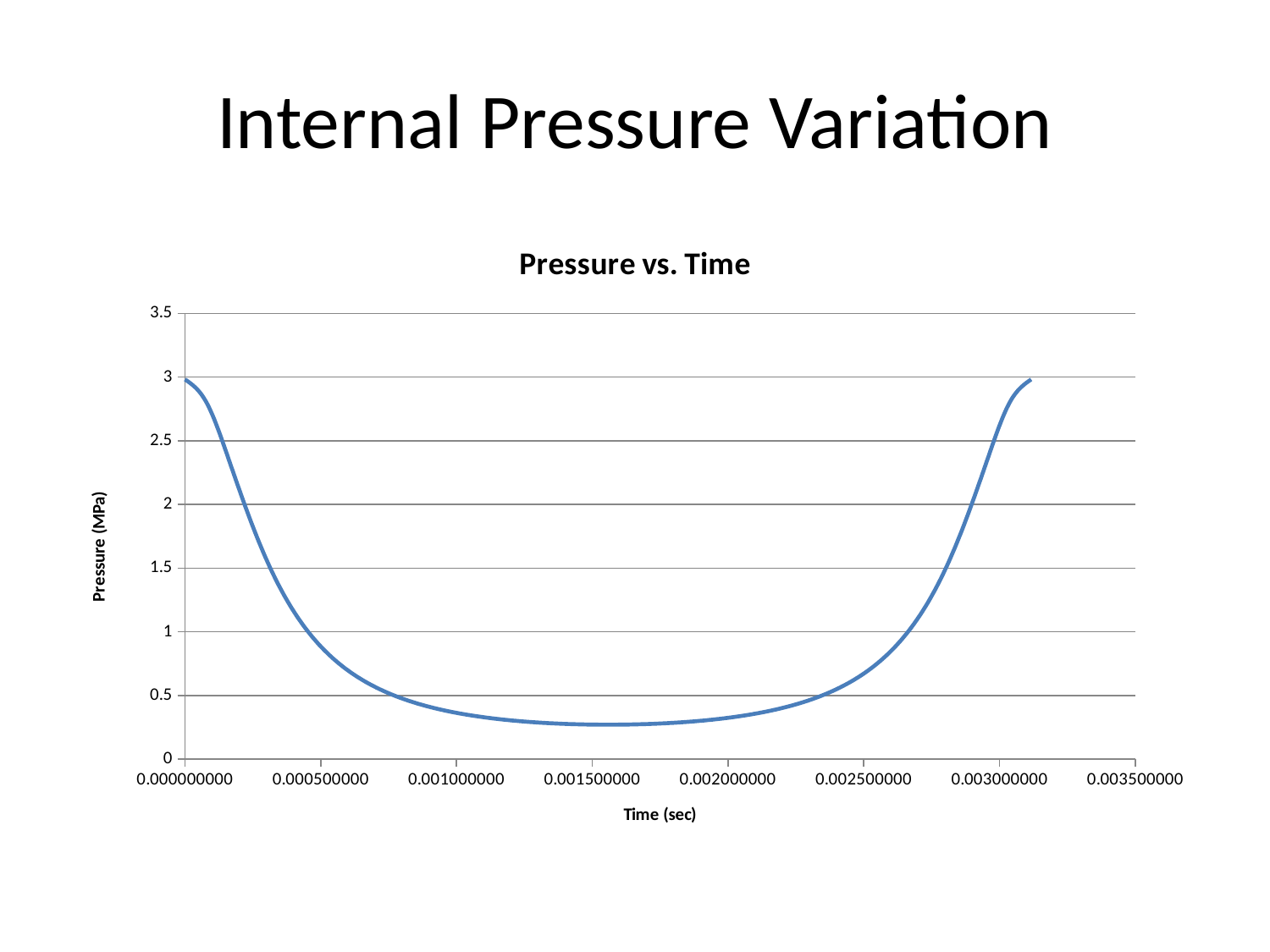
What is the title of the chart? Pressure vs. Time What is the label of the vertical axis? Pressure (MPa) Is the pressure at time 0.000500000 greater or less than 1? less Is the pressure at time 0.001000000 greater or less than 0.5? less Which is larger, the pressure at time 0.000500000 or the pressure at time 0.001500000? 0.000500000 Is the pressure at time 0.002500000 greater or less than 0.5? greater What kind of chart is shown on the slide? line chart Does the pressure rise or fall between time 0.002000000 and time 0.003000000? rise Does the pressure rise or fall between time 0.000000000 and time 0.001000000? fall